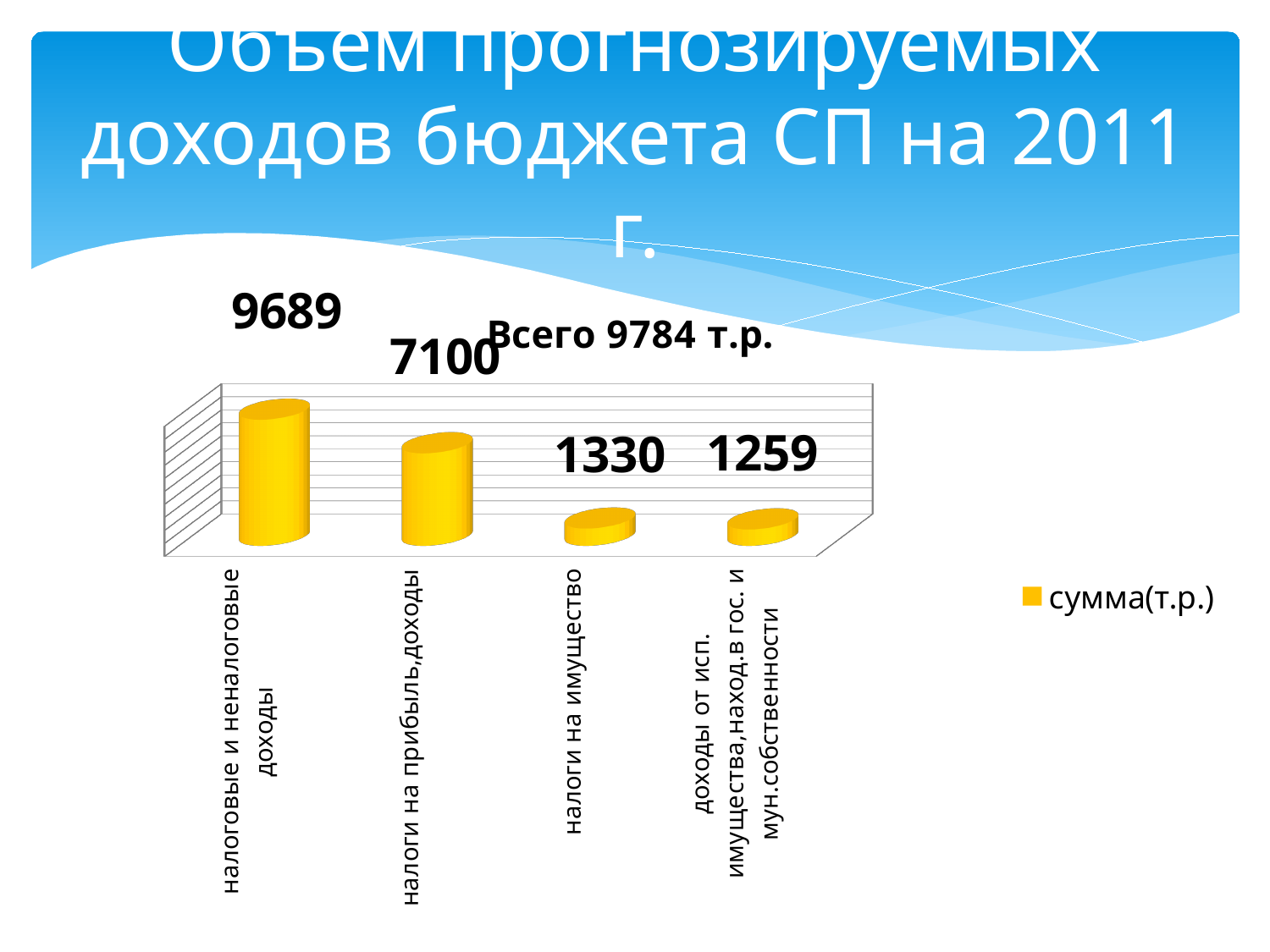
What is the value for налоги на имущество? 1330 Which is larger: the value for налоги на прибыль,доходы or the value for налоги на имущество? налоги на прибыль,доходы What series name does the legend show? сумма(т.р.) What is the value for доходы от исп. имущества,наход.в гос. и мун.собственности? 1259 What is the difference between the values for налоги на имущество and доходы от исп. имущества,наход.в гос. и мун.собственности? 71 Which category has the lowest value? доходы от исп. имущества,наход.в гос. и мун.собственности What kind of chart is shown on the slide? bar chart What is the value for налоги на прибыль,доходы? 7100 What is the difference between the values for налоговые и неналоговые доходы and налоги на прибыль,доходы? 2589 What is the value for налоговые и неналоговые доходы? 9689 How many categories are shown in the chart? 4 Which category has the highest value? налоговые и неналоговые доходы